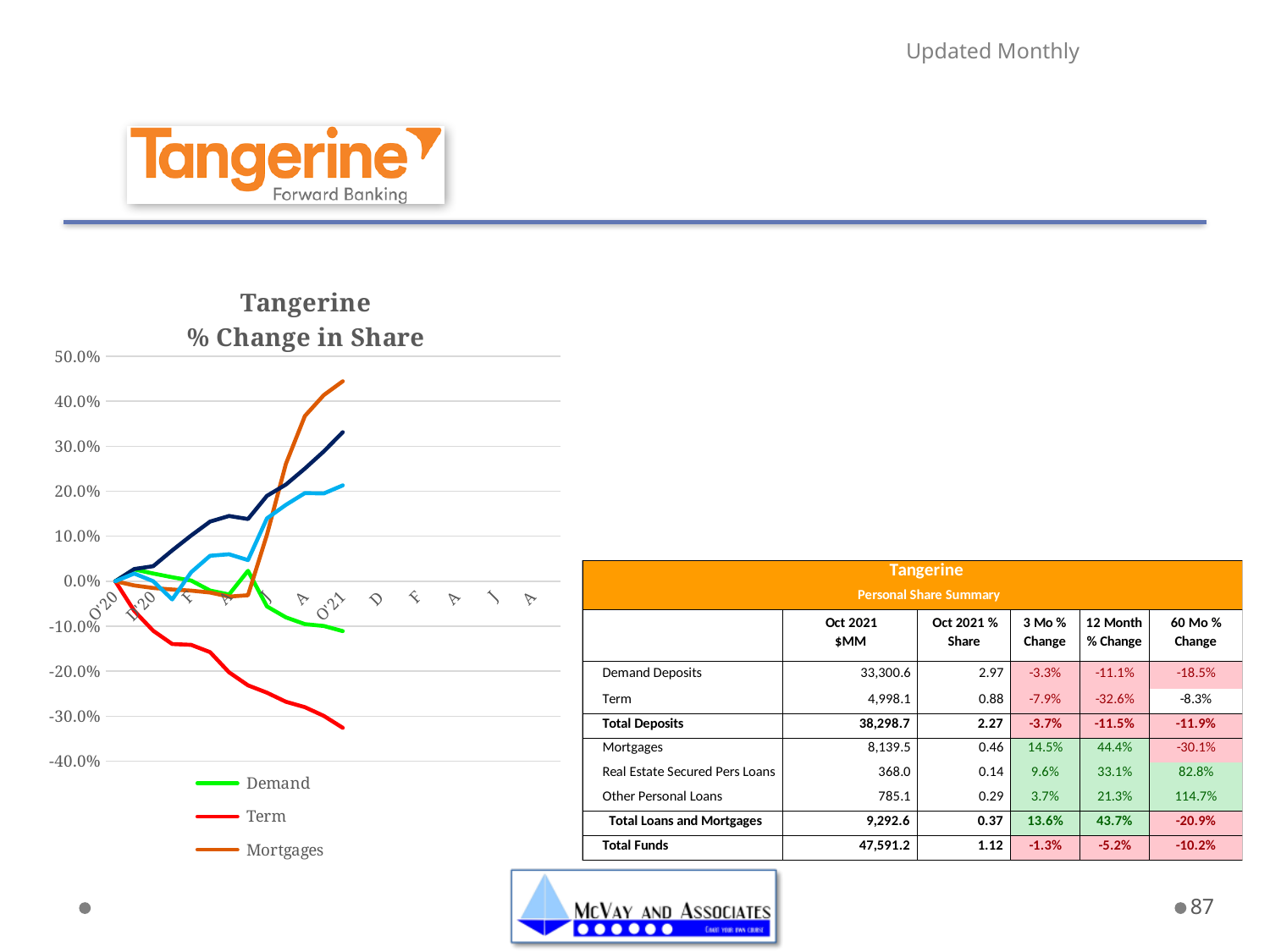
In the "Tangerine % Change in Share" chart, is the final value of the Mortgages series greater or less than 40.0%? greater In the "Tangerine % Change in Share" chart, which is larger at the end of the period: Mortgages or Term? Mortgages Which series in the "Tangerine % Change in Share" chart has the lowest value at the end of the plotted period? Term In the "Tangerine % Change in Share" chart, does the Mortgages series rise or fall overall along the x axis? rise What colour is the Term series in the "Tangerine % Change in Share" chart? red What kind of chart is the "Tangerine % Change in Share" chart? line chart In the "Tangerine % Change in Share" chart, is the final value of the Demand series greater or less than 0.0%? less What is the title of the line chart on the slide? Tangerine % Change in Share In the "Tangerine % Change in Share" chart, does the Term series rise or fall along the x axis? fall How many series does the legend of the "Tangerine % Change in Share" chart list? 3 Which series in the "Tangerine % Change in Share" chart has the highest value at the end of the plotted period? Mortgages In the "Tangerine % Change in Share" chart, is the final value of the Term series greater or less than -20.0%? less